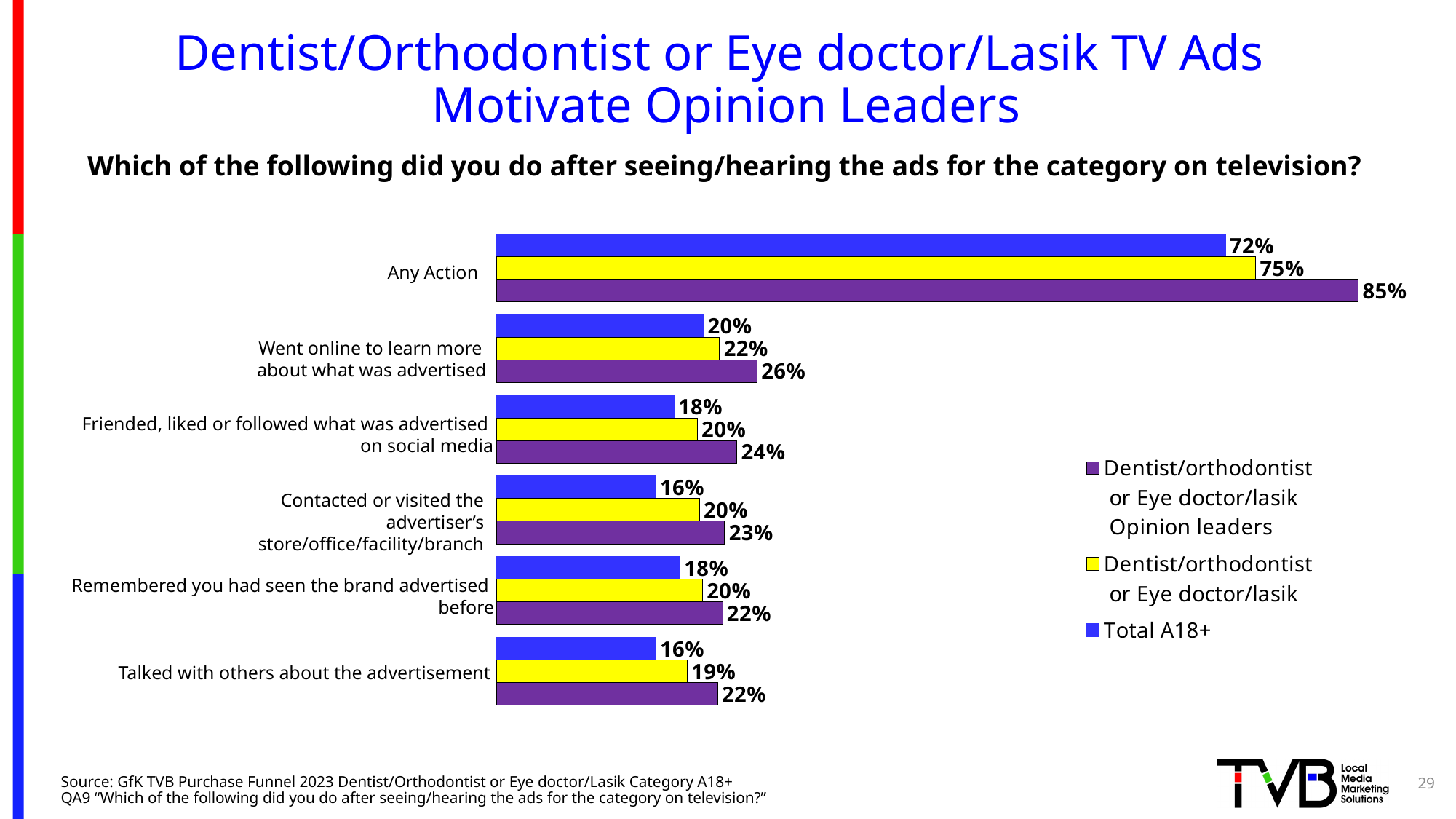
What is the value for Dentist/orthodontist or Eye doctor/lasik Opinion leaders for Any Action? 85% What is the value for Total A18+ for Talked with others about the advertisement? 16% For Went online to learn more about what was advertised, which is larger: the Opinion leaders value or the Total A18+ value? Opinion leaders What is the difference between the Opinion leaders value and the Total A18+ value for Any Action? 13% How many categories are shown on the chart? 6 What is the value for Total A18+ for Any Action? 72% Which category has the highest value for the Opinion leaders series? Any Action What kind of chart is shown on the slide? Bar chart What colour are the bars for the Total A18+ series? Blue Which category has the lowest value for the Dentist/orthodontist or Eye doctor/lasik series? Talked with others about the advertisement How many series does the legend list? 3 What is the value for Dentist/orthodontist or Eye doctor/lasik for Went online to learn more about what was advertised? 22%